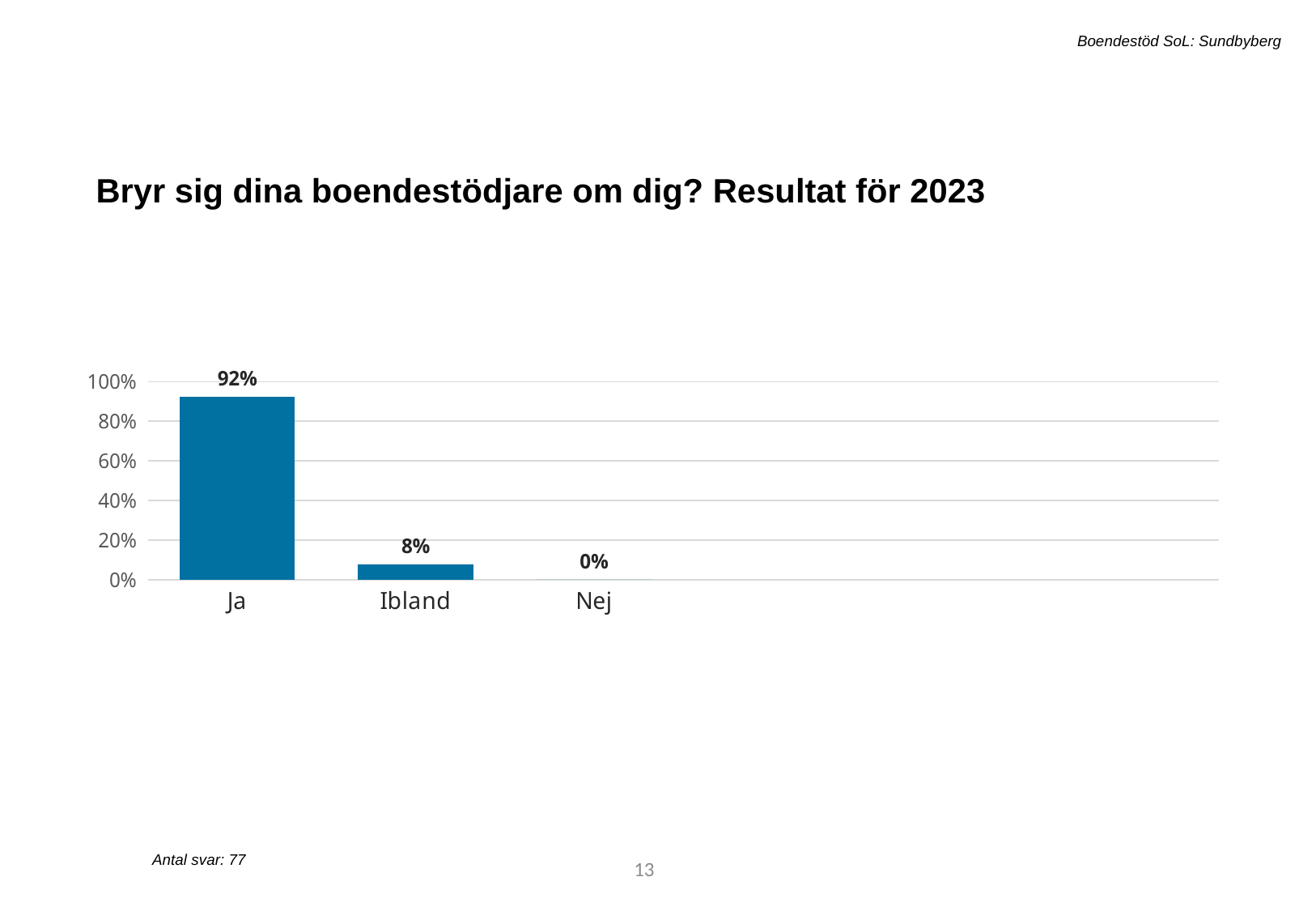
What is the value for Nej? 0% Which category has the highest value? Ja What is the title of the slide above the chart? Bryr sig dina boendestödjare om dig? Resultat för 2023 Which is larger, the value for Ibland or the value for Nej? Ibland Is the value for Ja greater or less than 80%? greater Do the values rise or fall from left to right along the x axis? fall What is the value for Ja? 92% What is the difference between the values for Ja and Ibland? 84% How many categories are shown on the x axis? 3 Which category has the lowest value? Nej What kind of chart is shown on the slide? bar chart What is the value for Ibland? 8%